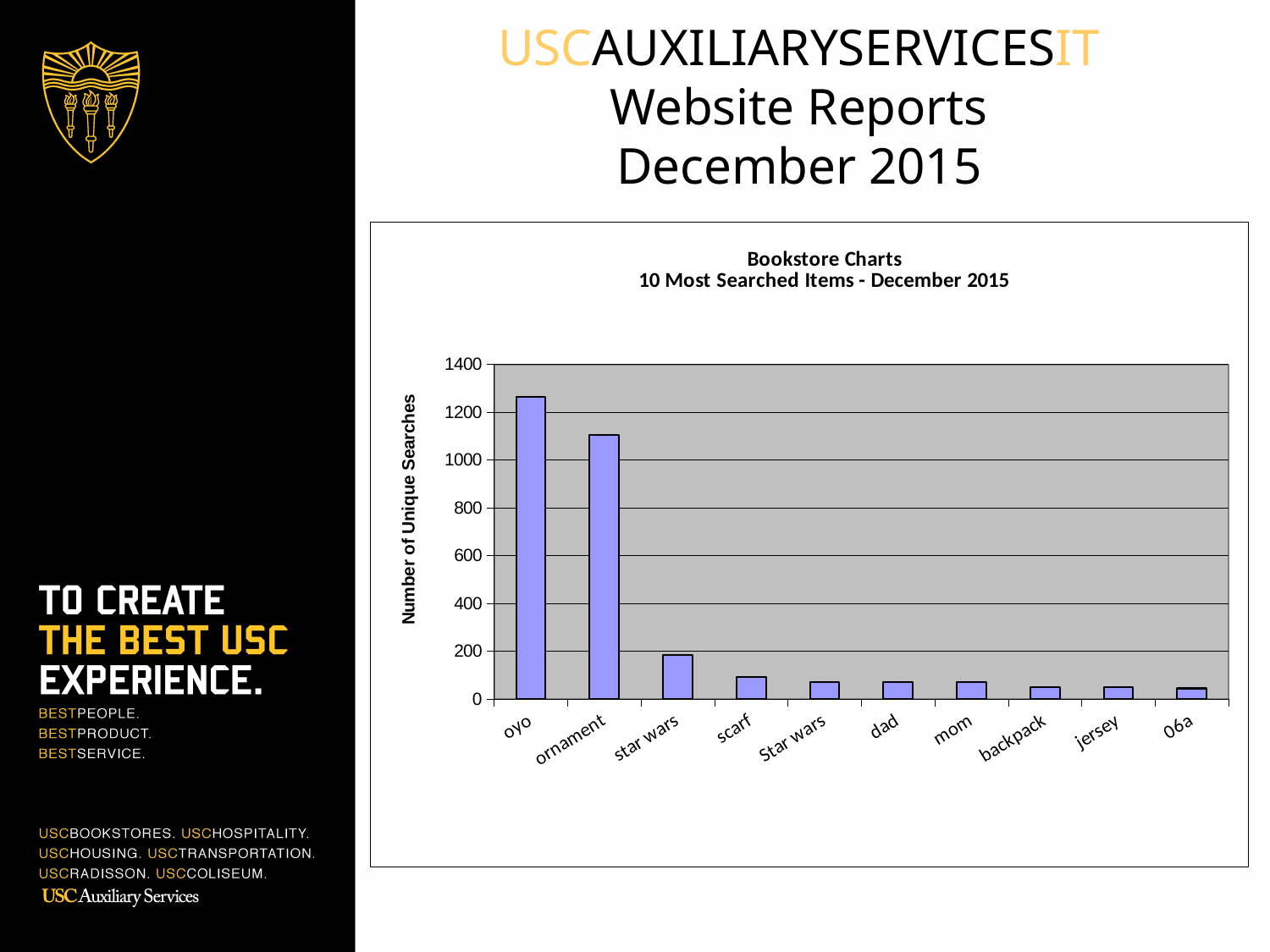
Which search term has the highest number of unique searches? oyo Is the value for ornament greater or less than 1200? less What is the title of the chart? Bookstore Charts 10 Most Searched Items - December 2015 Do the values generally rise or fall moving from left to right along the x axis? fall Is the value for ornament greater or less than 1000? greater Which has more unique searches, ornament or scarf? ornament Is the value for scarf greater or less than 200? less What kind of chart is shown on the slide? bar chart How many categories are plotted on the x axis of the chart? 10 What is the label on the y axis of the chart? Number of Unique Searches